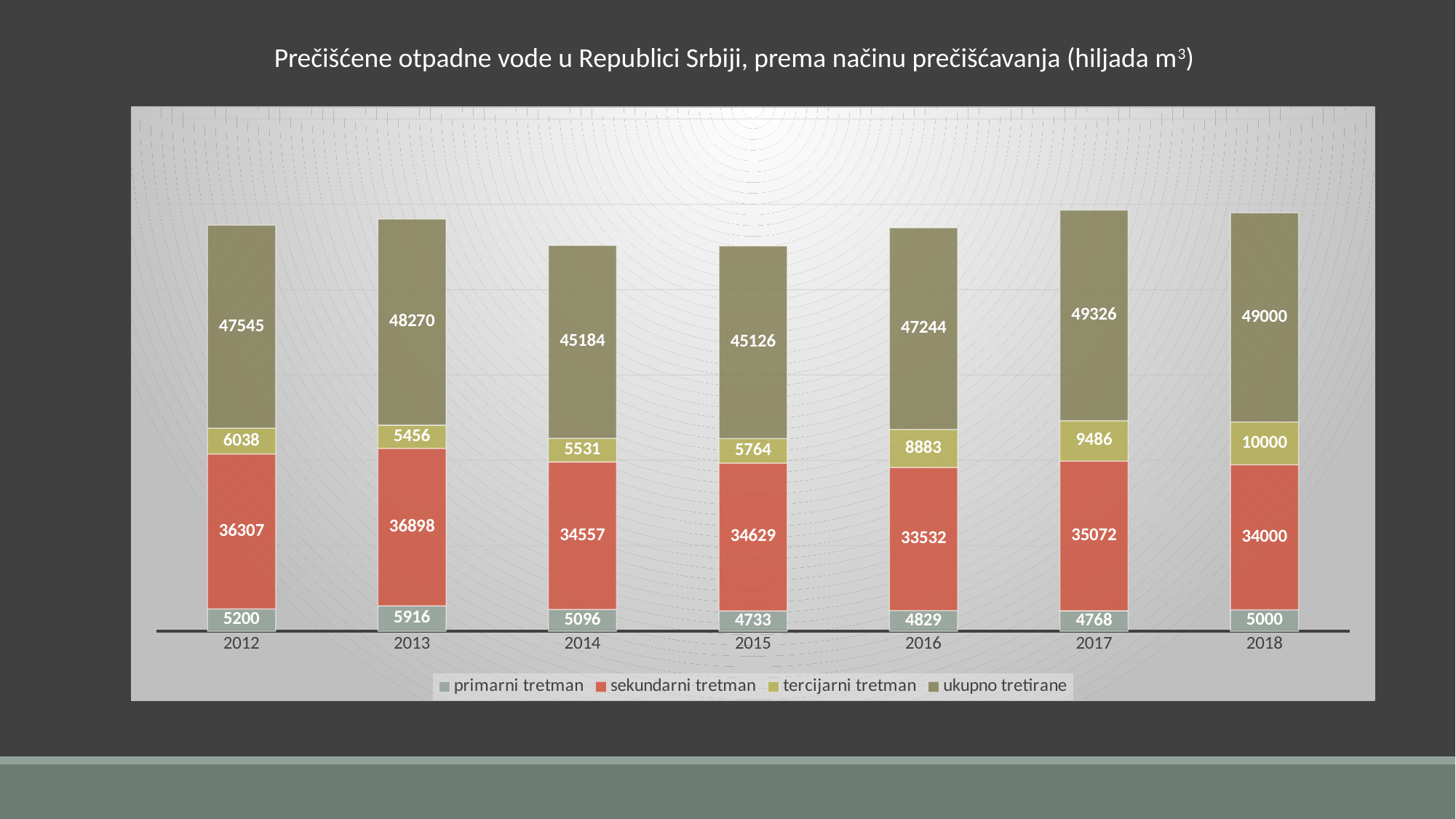
Which is larger: sekundarni tretman in 2013 or in 2017? 2013 In which year is tercijarni tretman lowest? 2013 What is the value for tercijarni tretman in 2017? 9486 What is the value for ukupno tretirane in 2014? 45184 What is the value for primarni tretman in 2013? 5916 What is the difference between tercijarni tretman in 2018 and in 2012? 3962 How many years are shown on the x axis? 7 In which year is ukupno tretirane highest? 2017 In which year is sekundarni tretman lowest? 2016 What is the value for sekundarni tretman in 2015? 34629 What kind of chart is shown on the slide? Stacked bar chart How many series does the legend list? 4